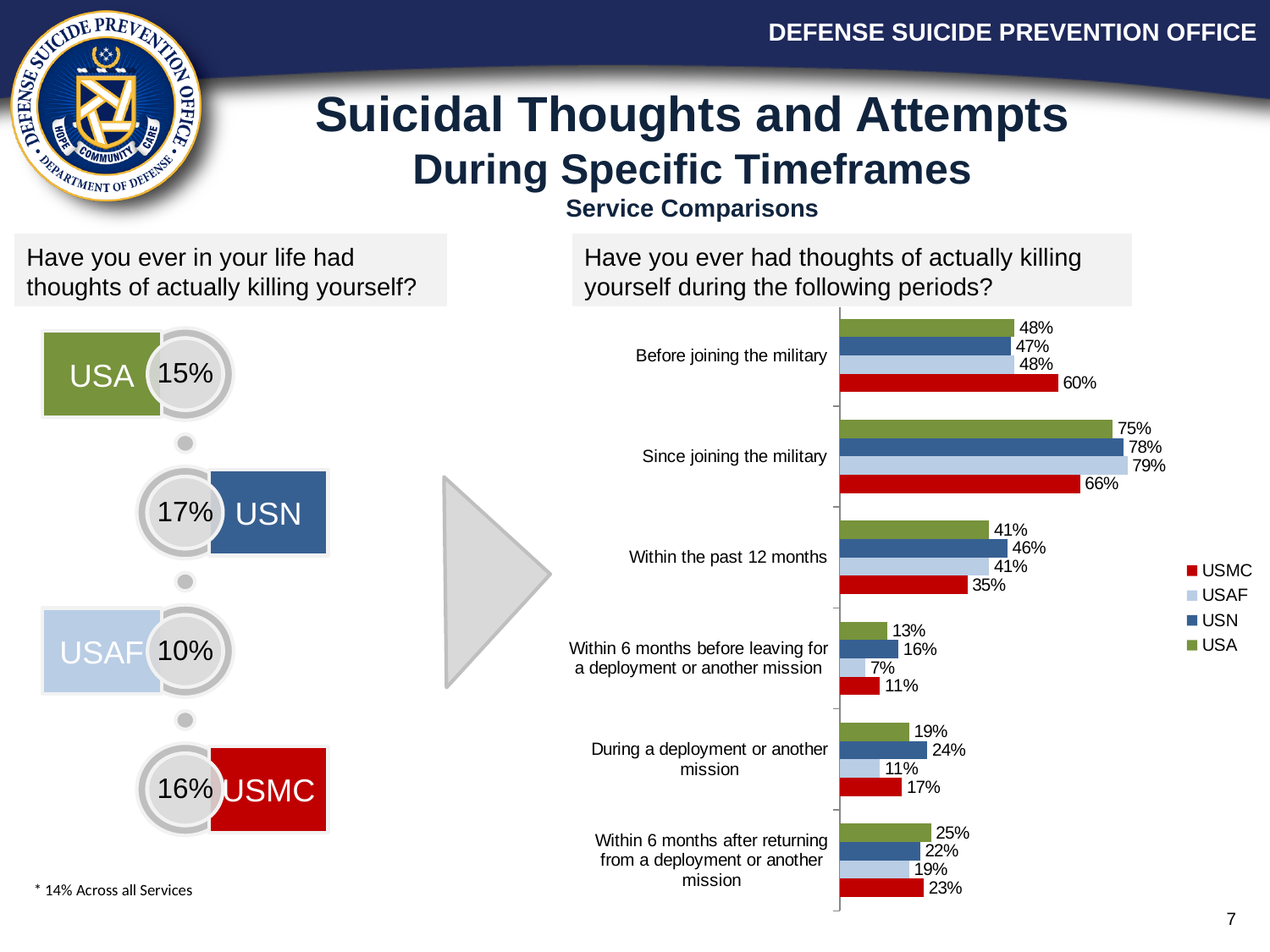
In the bar chart on the right, which is larger for 'Before joining the military': the USMC value or the USN value? USMC In the bar chart on the right, what is the USAF value for 'Since joining the military'? 79% In the bar chart on the right, which service has the lowest value for 'Within 6 months before leaving for a deployment or another mission'? USAF In the bar chart on the right, what is the USA value for 'Within 6 months after returning from a deployment or another mission'? 25% How many time-period categories does the bar chart on the right show? 6 In the bar chart on the right, what is the difference between the USAF and USMC values for 'Since joining the military'? 13% In the bar chart on the right, what is the USN value for 'During a deployment or another mission'? 24% In the bar chart on the right, which service has the highest value for 'Within the past 12 months'? USN In the bar chart on the right, what is the USMC value for 'Before joining the military'? 60% In the bar chart on the right, which colour represents USMC in the legend? Red How many series does the legend of the bar chart on the right list? 4 What type of chart is shown on the right side of the slide? Bar chart